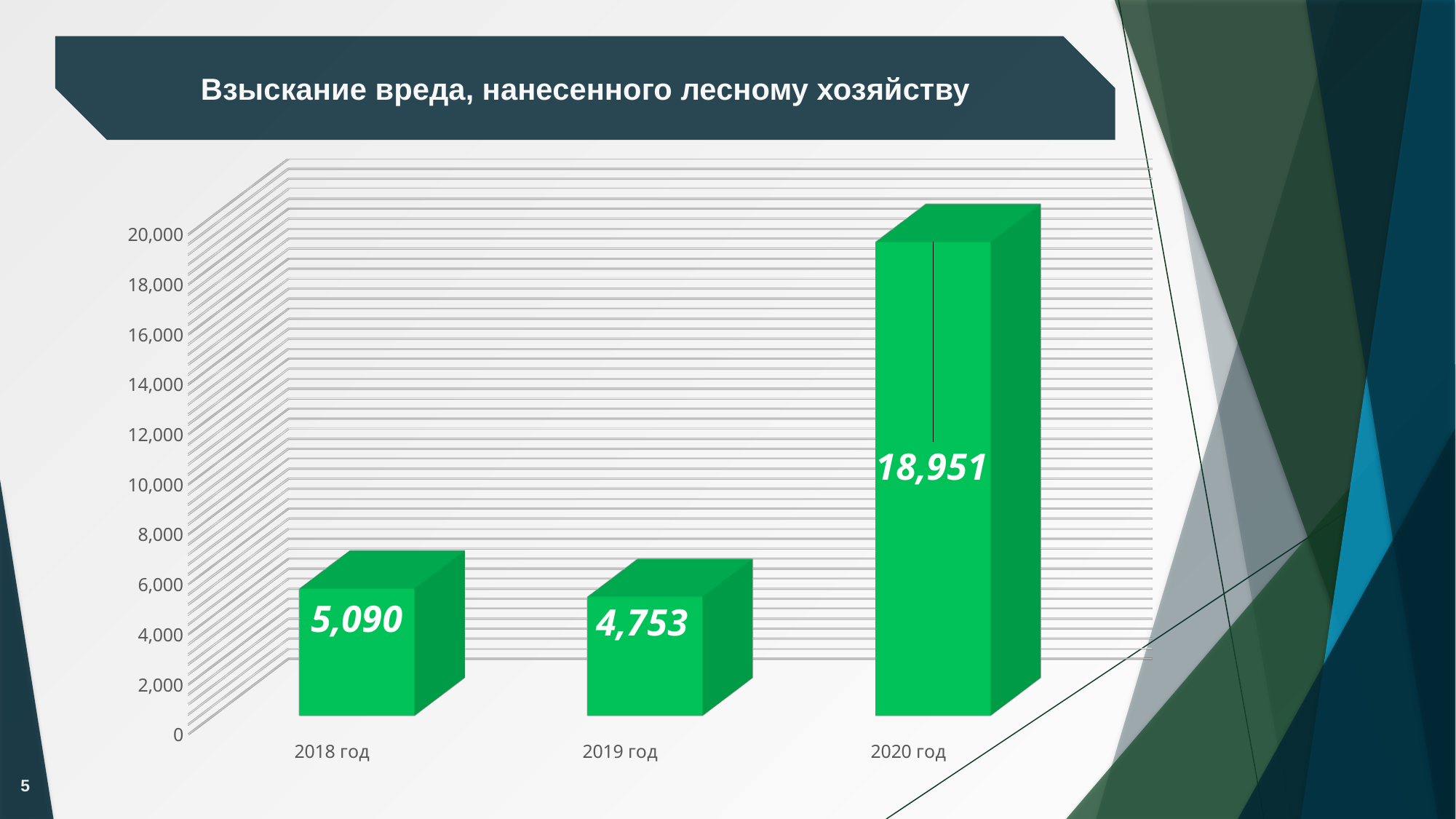
How many years are shown on the chart? 3 What is the value for 2019 год? 4,753 What is the difference between the values for 2020 год and 2018 год? 13,861 What is the value for 2020 год? 18,951 Which year has the lowest value? 2019 год What kind of chart is shown on the slide? bar chart What is the difference between the values for 2018 год and 2019 год? 337 What is the title of the chart? Взыскание вреда, нанесенного лесному хозяйству Is the value for 2020 год greater or less than 18,000? greater Which year has the highest value? 2020 год Which is larger, the value for 2018 год or 2019 год? 2018 год What is the value for 2018 год? 5,090